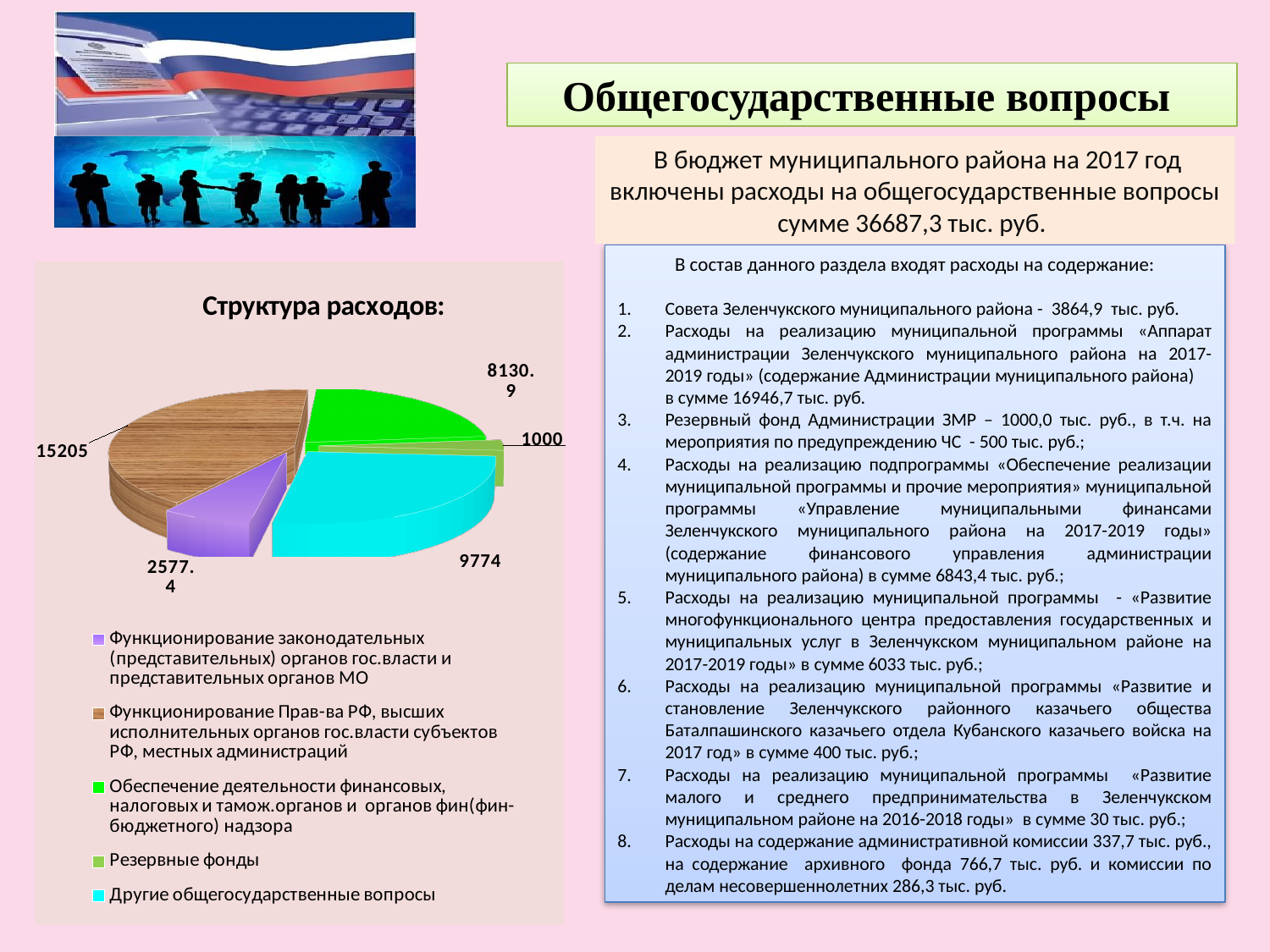
How many slices does the pie chart "Структура расходов:" have? 5 What is the title of the pie chart on the slide? Структура расходов: What is the total of all five slice values in the pie chart "Структура расходов:"? 36687.3 What is the value of the "Другие общегосударственные вопросы" slice in the pie chart? 9774 What is the value of the "Функционирование Прав-ва РФ, высших исполнительных органов гос.власти субъектов РФ, местных администраций" slice? 15205 What is the value of the "Функционирование законодательных (представительных) органов гос.власти и представительных органов МО" slice? 2577.4 What kind of chart is shown under the title "Структура расходов:"? pie chart What is the difference between the "Функционирование Прав-ва РФ..." slice (15205) and the "Другие общегосударственные вопросы" slice (9774)? 5431 Which is larger in the pie chart: "Обеспечение деятельности финансовых, налоговых и тамож.органов и органов фин(фин-бюджетного) надзора" or "Другие общегосударственные вопросы"? Другие общегосударственные вопросы Which category has the largest slice in the pie chart "Структура расходов:"? Функционирование Прав-ва РФ, высших исполнительных органов гос.власти субъектов РФ, местных администраций Which category has the smallest slice in the pie chart "Структура расходов:"? Резервные фонды What is the value of the "Резервные фонды" slice in the pie chart? 1000